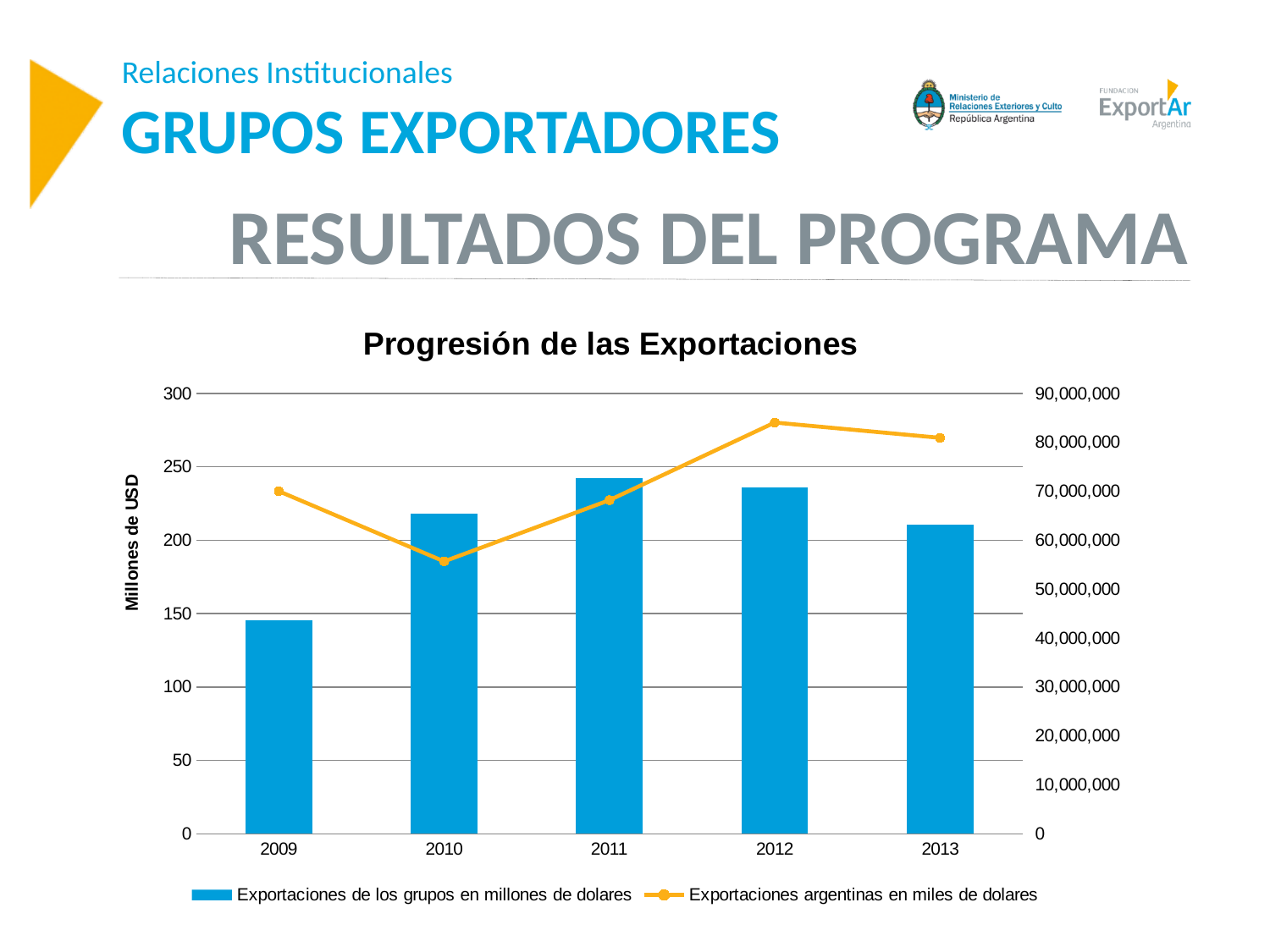
Which year has the lowest bar for 'Exportaciones de los grupos en millones de dolares'? 2009 What is the title of the chart? Progresión de las Exportaciones How many years are shown on the x axis of the chart? 5 Which year has the larger bar, 2009 or 2010? 2010 Is the bar value for 2013 greater or less than 200? greater How many series does the legend list? 2 Do the bar values rise or fall from 2009 to 2011? rise Is the line value for 2012 greater or less than 80,000,000? greater Is the bar value for 2009 greater or less than 150? less In which year does the line 'Exportaciones argentinas en miles de dolares' reach its highest point? 2012 In which year does the line 'Exportaciones argentinas en miles de dolares' reach its lowest point? 2010 What kind of chart is shown on the slide? A combined bar and line chart